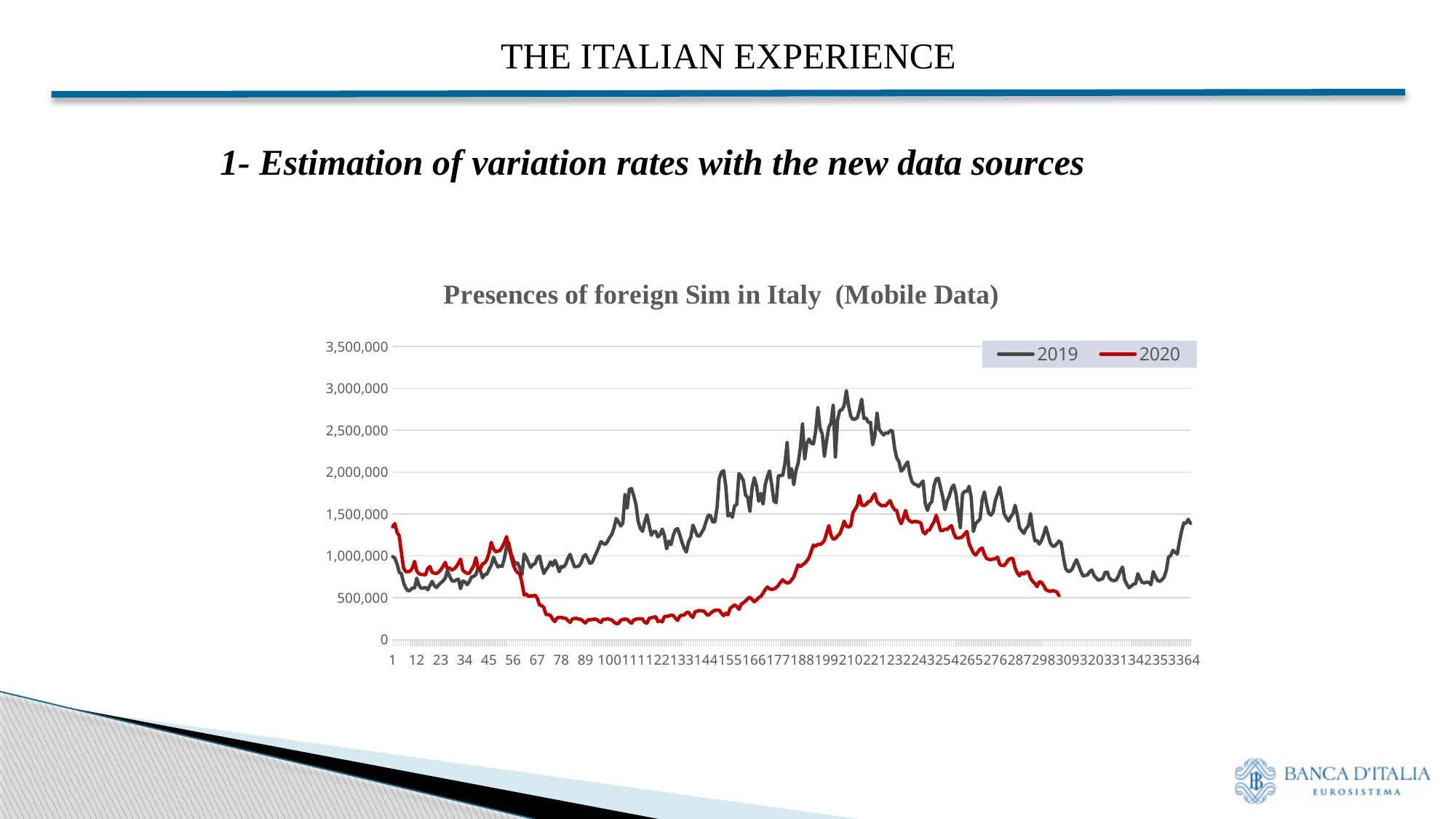
What kind of chart is shown on the slide? line chart Is the highest value of the 2019 series greater or less than 2,500,000? greater What is the highest value labelled on the vertical axis? 3,500,000 Is the value of the 2020 series around day 100 greater or less than 500,000? less Is the value of the 2019 series at day 1 greater or less than 1,500,000? less At day 1, which series has the higher value, 2019 or 2020? 2020 Does the 2020 series rise or fall between about day 230 and day 300? fall What are the two series named in the chart legend? 2019 and 2020 Around day 210, which series has the higher value, 2019 or 2020? 2019 What is the title of the chart? Presences of foreign Sim in Italy (Mobile Data) How many series does the legend of the chart list? 2